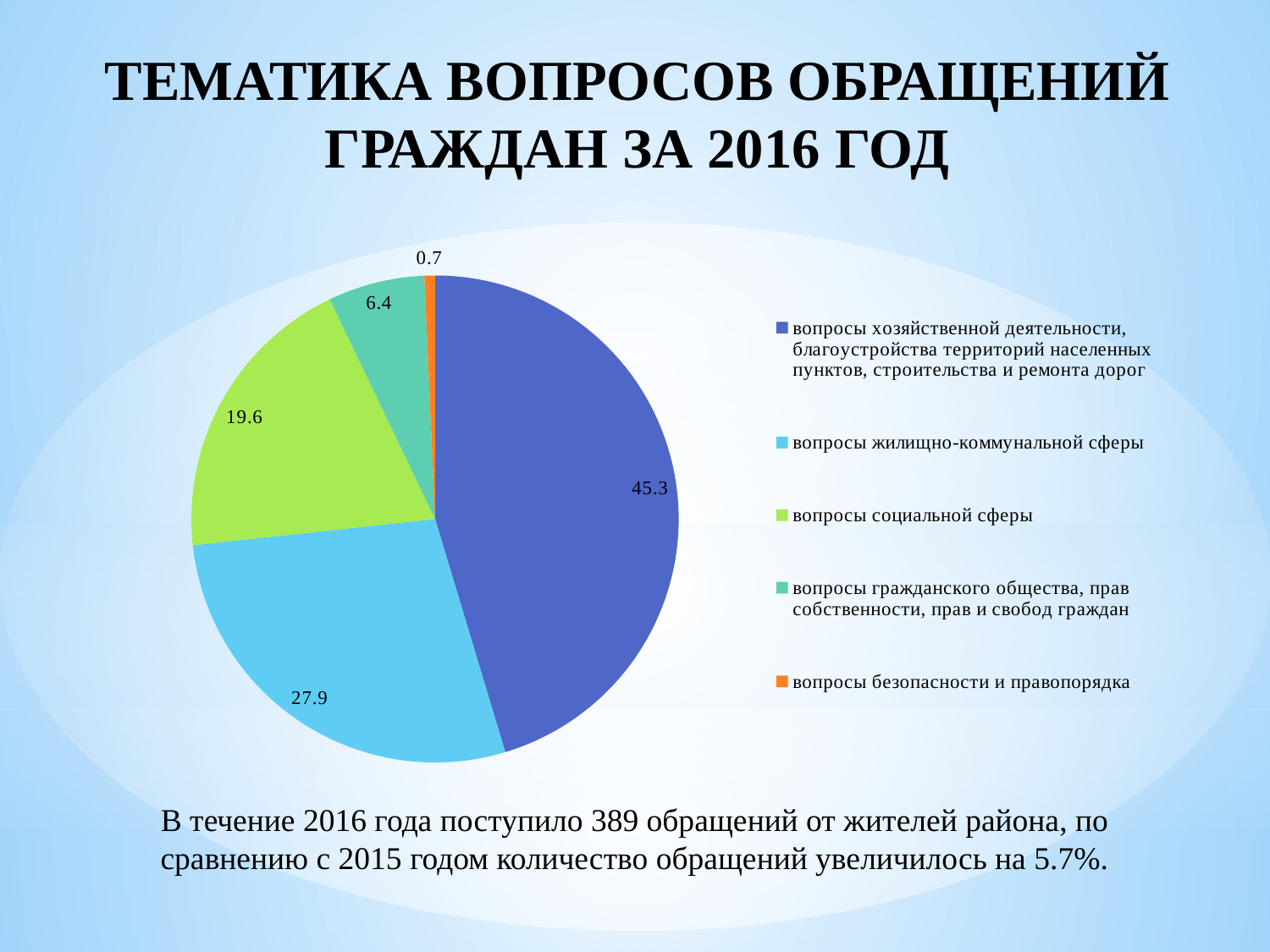
What is the difference between the values for "вопросы жилищно-коммунальной сферы" and "вопросы социальной сферы"? 8.3 Which category has the smallest slice of the pie? вопросы безопасности и правопорядка What value is shown for the slice "вопросы жилищно-коммунальной сферы"? 27.9 How many slices does the pie chart have? 5 Which category has the largest slice of the pie? вопросы хозяйственной деятельности, благоустройства территорий населенных пунктов, строительства и ремонта дорог What value is shown for the slice "вопросы гражданского общества, прав собственности, прав и свобод граждан"? 6.4 What value is shown for the slice "вопросы безопасности и правопорядка"? 0.7 What kind of chart is shown on the slide? pie chart What colour is the slice for "вопросы безопасности и правопорядка"? orange What value is shown for the slice "вопросы социальной сферы"? 19.6 How many entries does the legend of the pie chart list? 5 Which is larger: the slice for "вопросы социальной сферы" or the slice for "вопросы гражданского общества, прав собственности, прав и свобод граждан"? вопросы социальной сферы